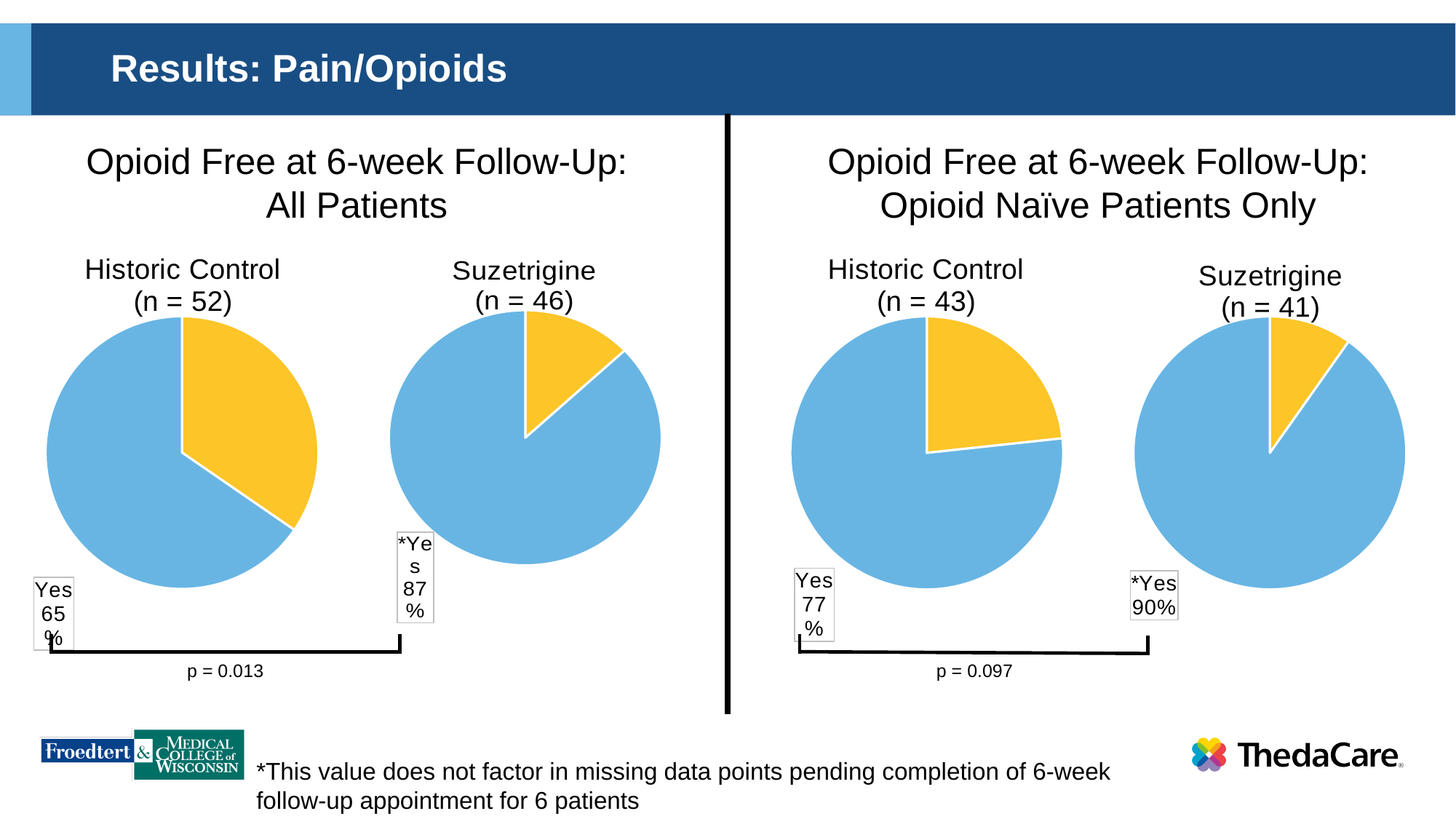
In the 'Opioid Naïve Patients Only' section, what is the difference in the opioid-free (Yes) percentage between Suzetrigine and Historic Control? 13 percentage points What is the sample size (n) for the Historic Control group in the 'Opioid Naïve Patients Only' section? 43 In the 'All Patients' section, which group has the larger opioid-free (Yes) share: Historic Control or Suzetrigine? Suzetrigine What type of chart is used to show the opioid-free results on this slide? Pie chart What p-value is shown for the comparison in the 'All Patients' section? p = 0.013 In the 'Opioid Free at 6-week Follow-Up: All Patients' Historic Control pie chart, what percentage of patients were opioid free (Yes)? 65% In the 'All Patients' section, what is the difference in the opioid-free (Yes) percentage between Suzetrigine and Historic Control? 22 percentage points In the 'Opioid Free at 6-week Follow-Up: Opioid Naïve Patients Only' Historic Control pie chart, what percentage of patients were opioid free (Yes)? 77% In the 'Opioid Naïve Patients Only' section, which group has the larger opioid-free (Yes) share: Historic Control or Suzetrigine? Suzetrigine In the 'Opioid Free at 6-week Follow-Up: All Patients' Suzetrigine pie chart, what percentage of patients were opioid free (Yes)? 87% How many pie charts are shown on the slide? 4 In the 'Opioid Free at 6-week Follow-Up: Opioid Naïve Patients Only' Suzetrigine pie chart, what percentage of patients were opioid free (Yes)? 90%